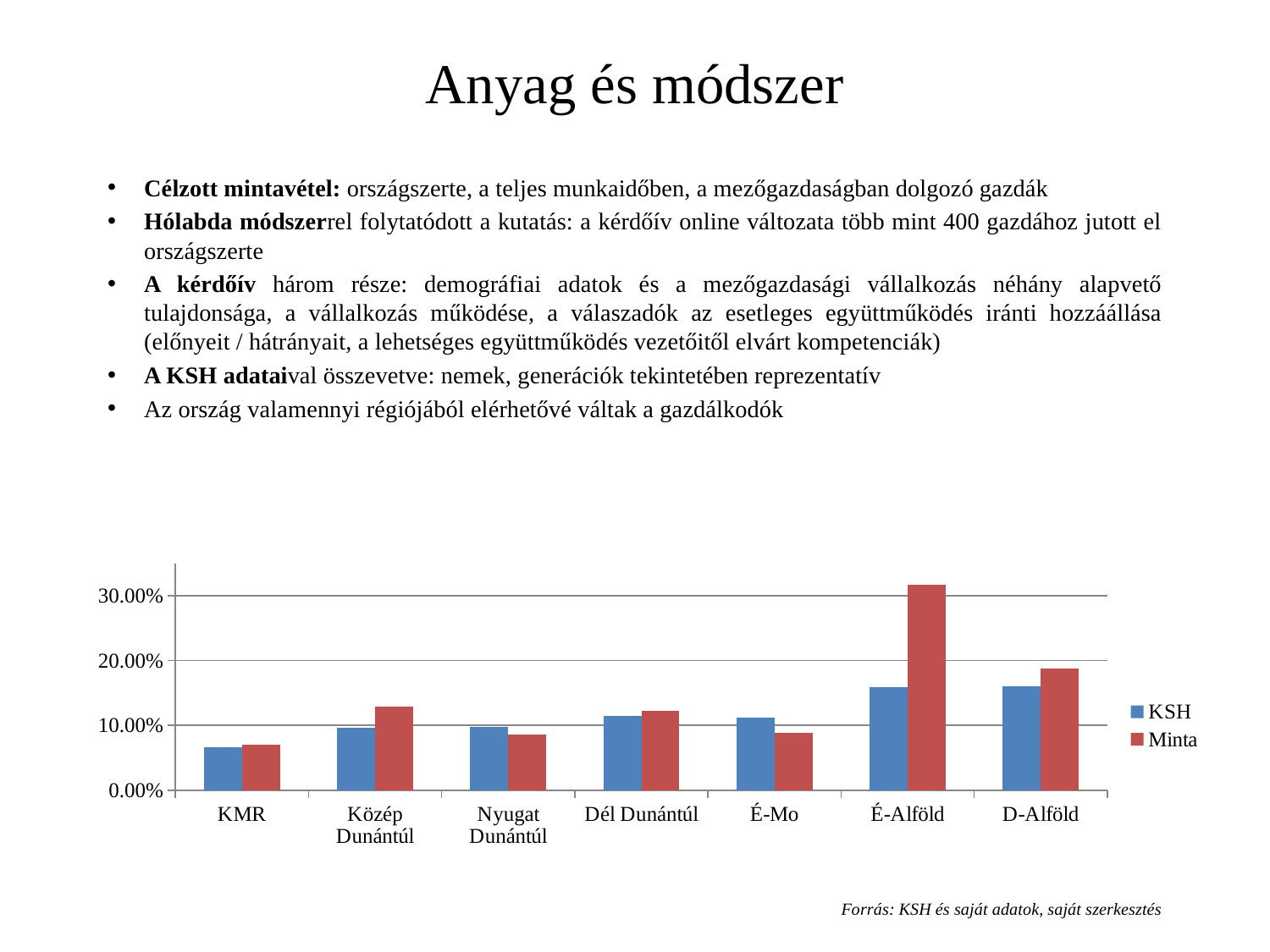
How many regions (categories) are shown on the x axis of the chart? 7 Which region has the lowest Minta value? KMR What kind of chart is shown on the slide? bar chart For É-Mo, which is larger: the KSH value or the Minta value? KSH Which region has the highest Minta value? É-Alföld How many series does the chart's legend list? 2 What are the two series named in the chart's legend? KSH and Minta Which region has the lowest KSH value? KMR Is the KSH value for KMR greater or less than 10.00%? less For É-Alföld, which is larger: the KSH value or the Minta value? Minta Is the Minta value for É-Alföld greater or less than 30.00%? greater Is the KSH value for D-Alföld greater or less than 20.00%? less